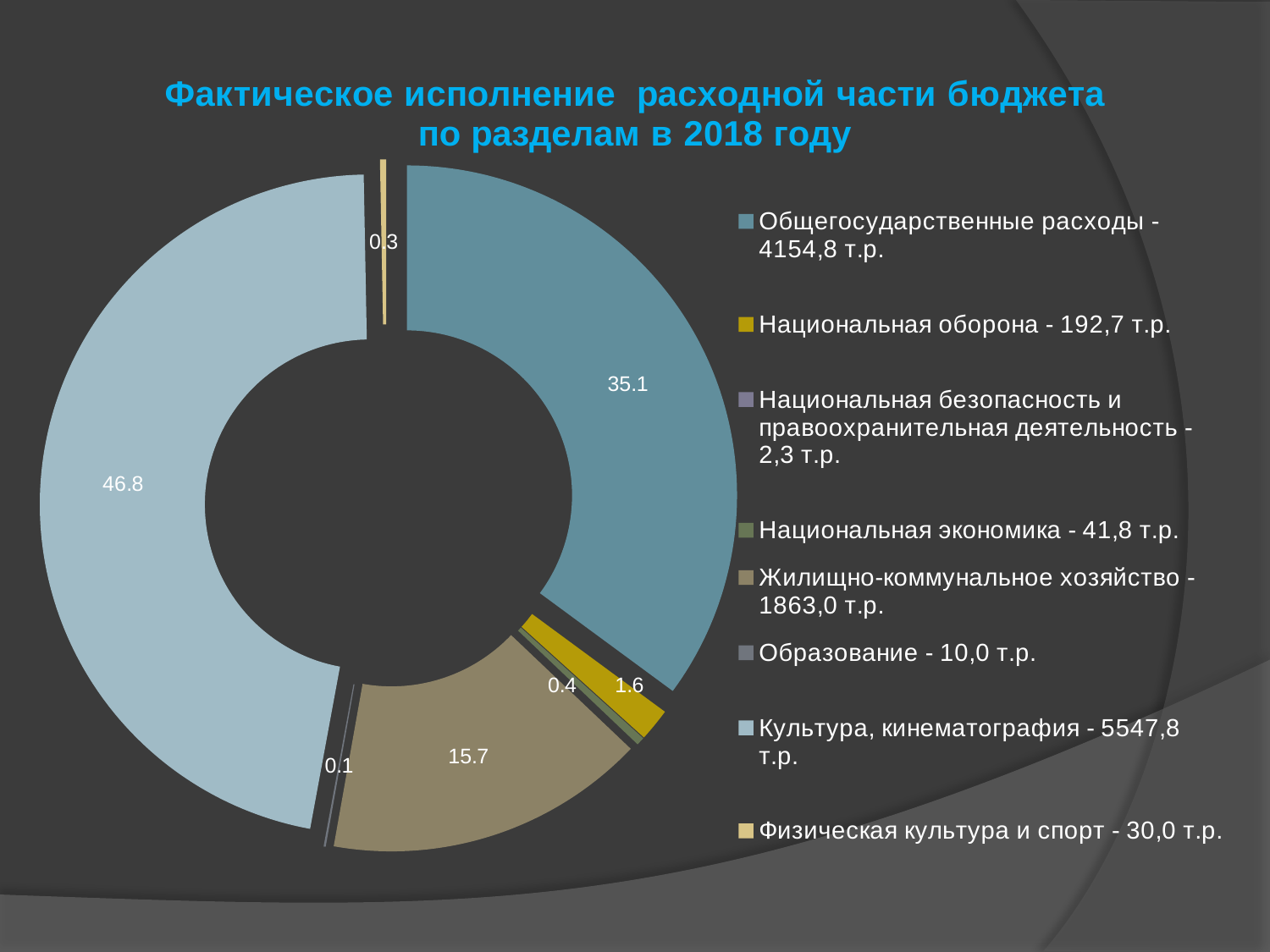
According to the legend, what amount is given for 'Национальная экономика'? 41,8 т.р. According to the legend, what amount is given for 'Образование'? 10,0 т.р. What percentage label is shown for the slice 'Национальная оборона'? 1.6 Which is larger: the share for 'Общегосударственные расходы' or for 'Жилищно-коммунальное хозяйство'? Общегосударственные расходы Which section has the largest share of the chart? Культура, кинематография What percentage label is shown for the slice 'Общегосударственные расходы'? 35.1 What is the difference in percentage points between the 'Культура, кинематография' slice (46.8) and the 'Общегосударственные расходы' slice (35.1)? 11.7 What percentage label is shown for the slice 'Культура, кинематография'? 46.8 What kind of chart is shown on the slide? doughnut (pie) chart What is the title of the chart? Фактическое исполнение расходной части бюджета по разделам в 2018 году How many entries does the legend list? 8 What percentage label is shown for the slice 'Жилищно-коммунальное хозяйство'? 15.7